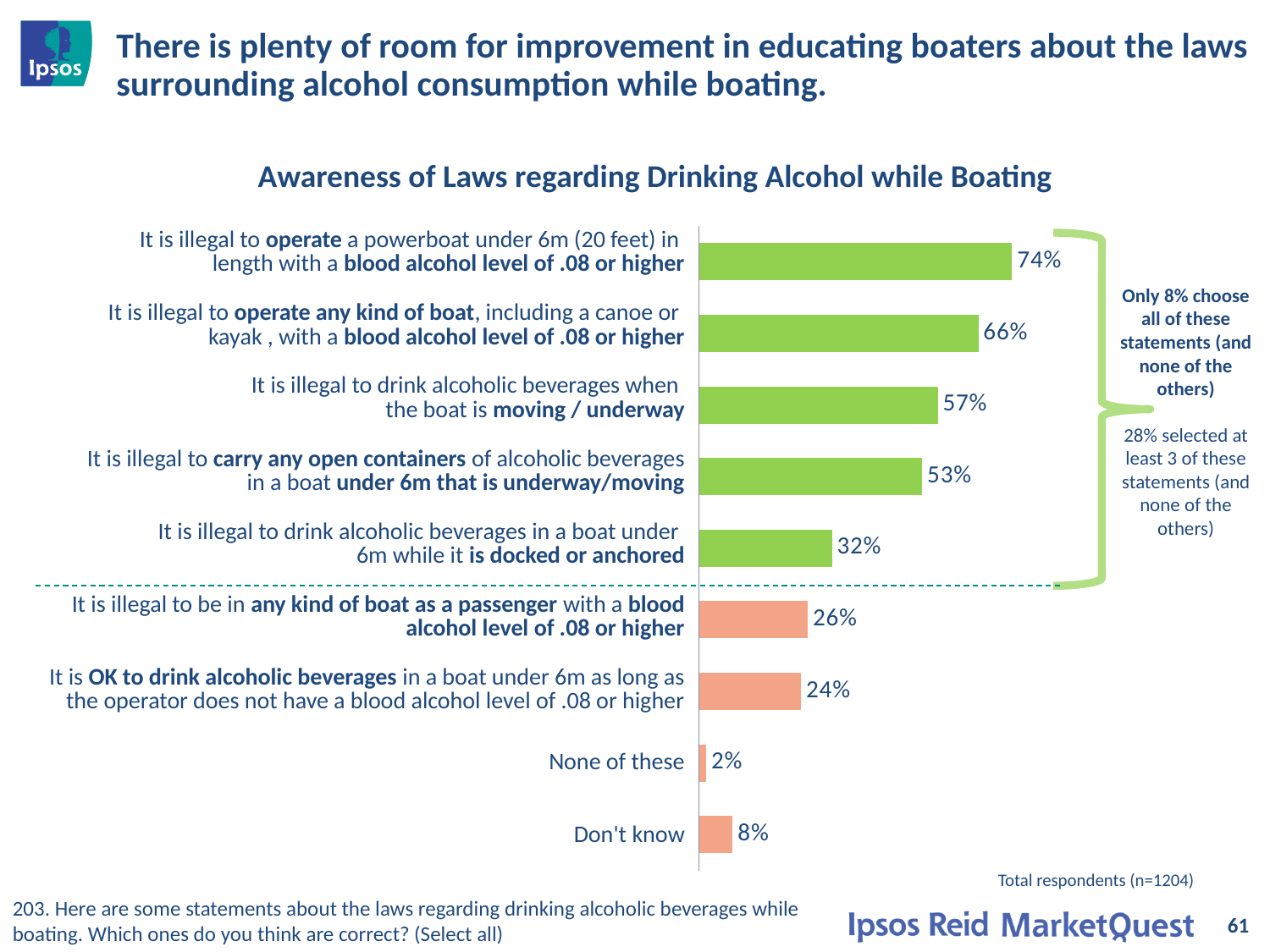
What percentage of respondents said it is illegal to operate a powerboat under 6m in length with a blood alcohol level of .08 or higher? 74% Which has a higher percentage: 'any kind of boat as a passenger with a blood alcohol level of .08 or higher' or 'OK to drink alcoholic beverages in a boat under 6m as long as the operator does not have a blood alcohol level of .08 or higher'? It is illegal to be in any kind of boat as a passenger with a blood alcohol level of .08 or higher Which statement has the highest percentage of respondents? It is illegal to operate a powerboat under 6m (20 feet) in length with a blood alcohol level of .08 or higher What is the difference in percentage points between the 'operate a powerboat under 6m' statement (74%) and the 'operate any kind of boat' statement (66%)? 8 Which category has the lowest percentage? None of these How many categories are shown in the chart? 9 What type of chart is shown on the slide? Bar chart What percentage of respondents said it is illegal to drink alcoholic beverages in a boat under 6m while it is docked or anchored? 32% What percentage of respondents said it is illegal to drink alcoholic beverages when the boat is moving / underway? 57% What percentage of respondents selected 'Don't know'? 8% How many bars in the chart are coloured orange rather than green? 4 What is the title of the chart? Awareness of Laws regarding Drinking Alcohol while Boating